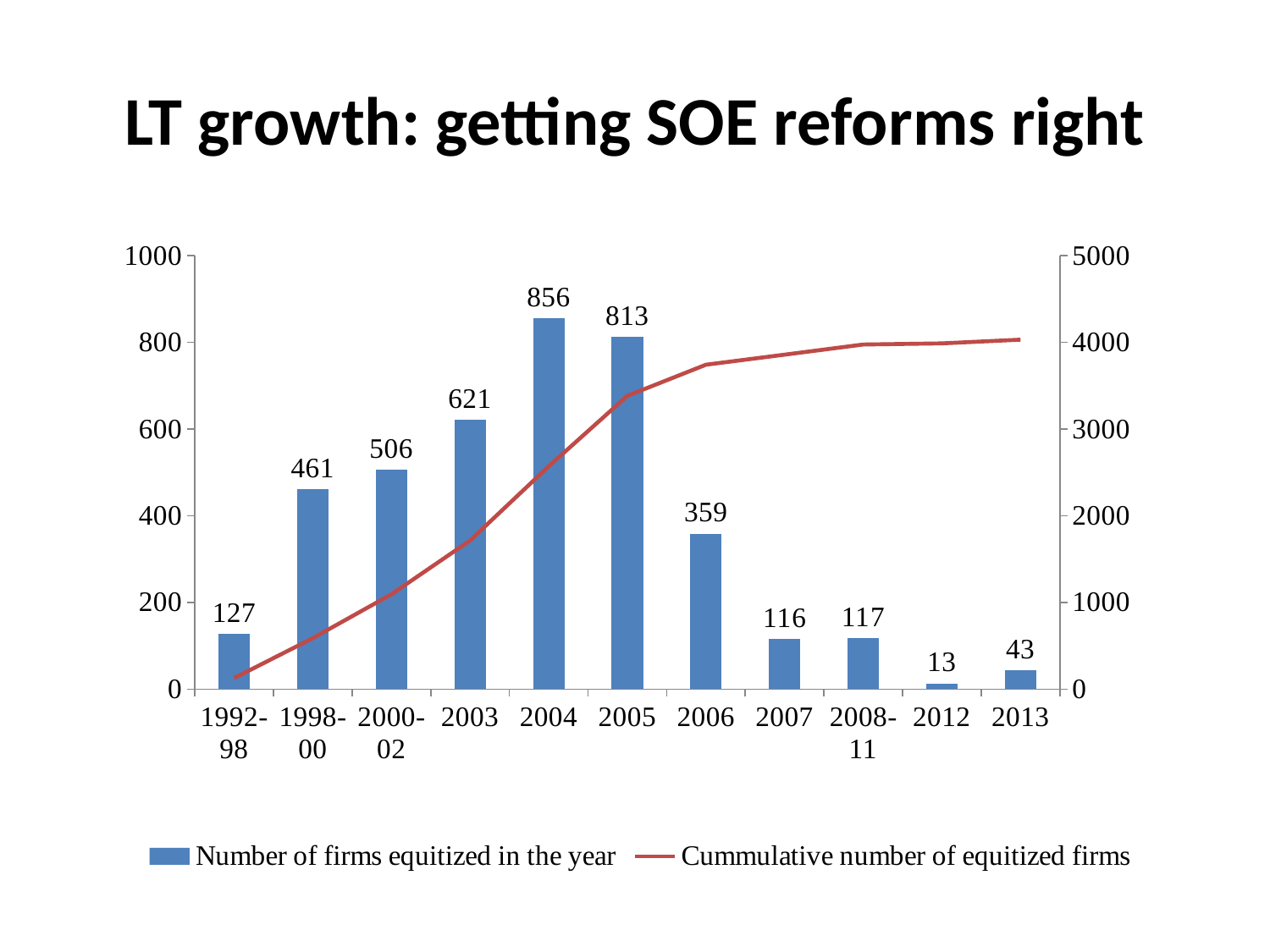
Does the cumulative number of equitized firms line rise or fall from left to right? rise Which period has the lowest number of firms equitized in the year? 2012 Which is larger, the number of firms equitized in 2007 or in 2008-11? 2008-11 How many periods are shown on the x axis of the chart? 11 What is the number of firms equitized in the year for the 1992-98 period? 127 What is the difference between the number of firms equitized in 2004 and in 2005? 43 How many firms were equitized in 2004 according to the bar chart? 856 Is the cumulative number of equitized firms in 2003 greater or less than 2000 on the right axis? less What colour is the line for the cumulative number of equitized firms? Red How many series does the legend list? 2 Which period has the highest number of firms equitized in the year? 2004